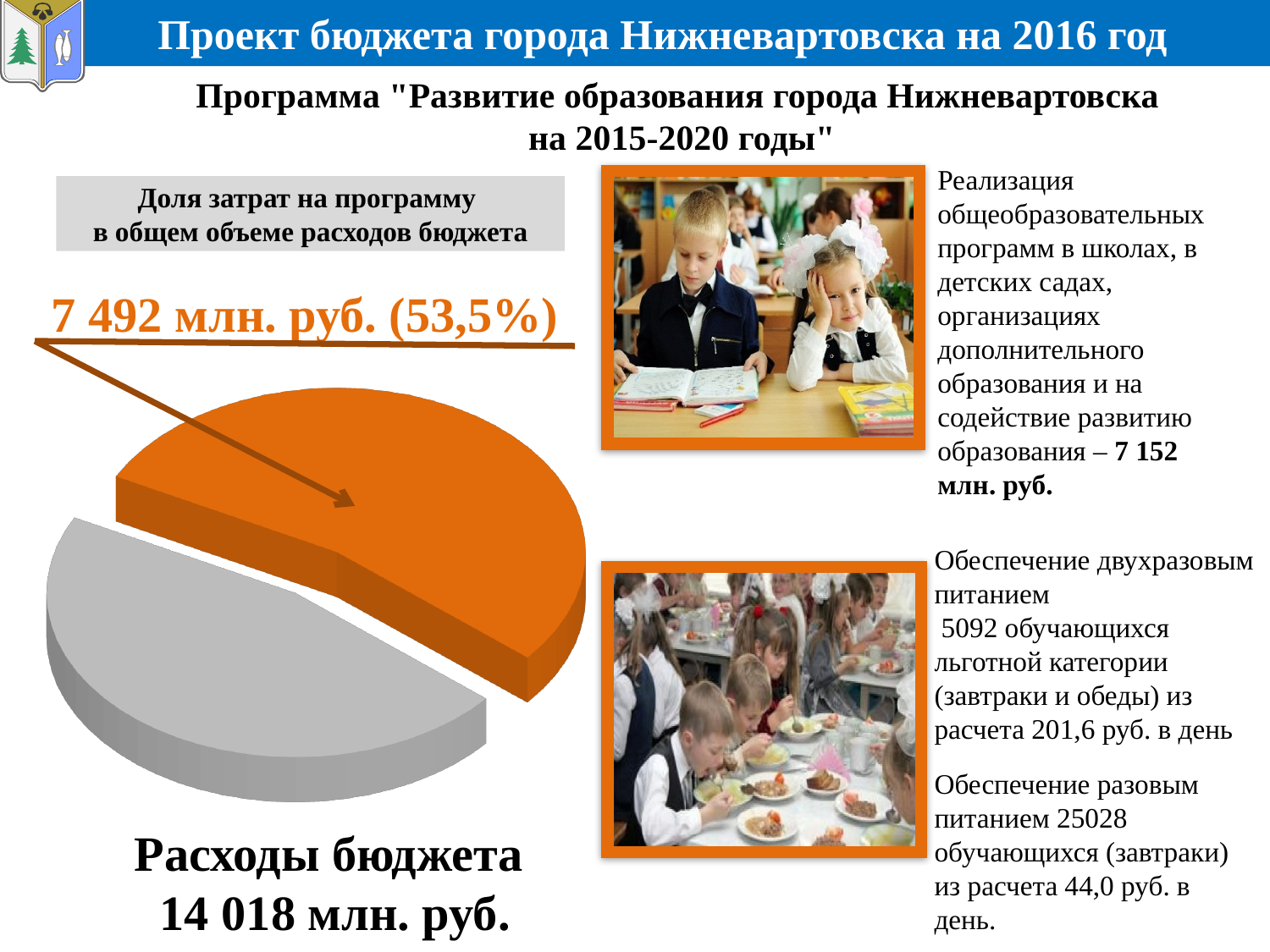
What kind of chart is shown on the slide? pie chart How many slices does the pie chart have? 2 Based on the total budget expenses of 14 018 млн. руб. and the program expenses of 7 492 млн. руб., how much do the remaining (grey slice) expenses amount to? 6 526 млн. руб. What is the total budget expenses figure shown below the pie chart? 14 018 млн. руб. What share of the total budget expenses does the program (orange slice) account for, according to the pie chart? 53,5% What is the value of the program expenses shown for the orange slice of the pie chart? 7 492 млн. руб. What colour is the slice representing the program expenses in the pie chart? orange Which slice of the pie chart is larger, the orange (program) slice or the grey slice? the orange (program) slice What is the title of the pie chart on the slide? Доля затрат на программу в общем объеме расходов бюджета Is the program's share of budget expenses in the pie chart greater or less than 50%? greater